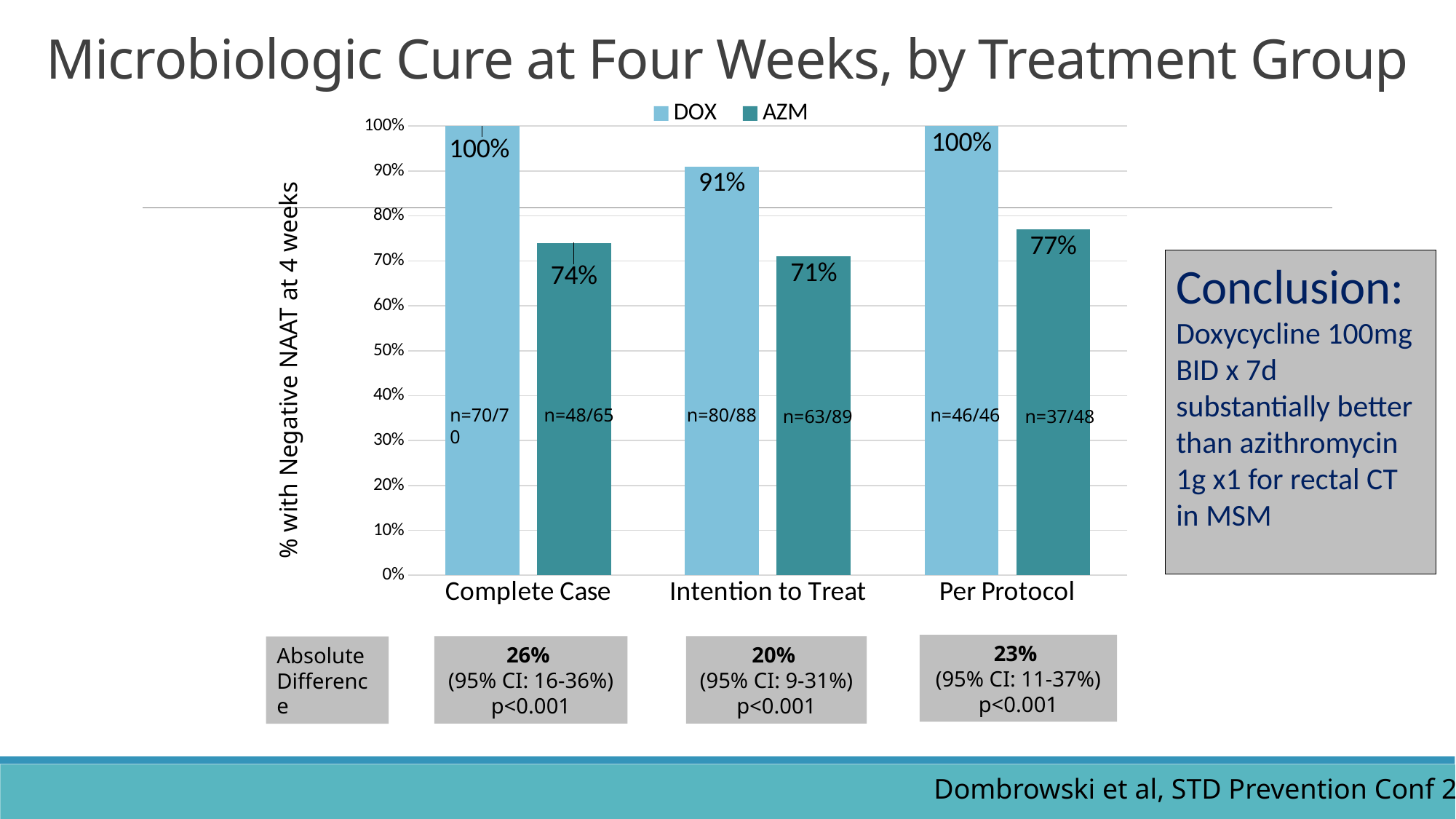
Which category has the lowest AZM value? Intention to Treat What is the DOX value for Intention to Treat? 91% Which category has the highest AZM value? Per Protocol How many series does the legend list? 2 What is the difference between the DOX and AZM values for Complete Case? 26% How many categories are shown on the x axis? 3 What is the y-axis label of the chart? % with Negative NAAT at 4 weeks Which is larger for Per Protocol, the DOX value or the AZM value? DOX What is the difference between the DOX and AZM values for Intention to Treat? 20% What is the AZM value for Complete Case? 74% What is the AZM value for Per Protocol? 77% What kind of chart is shown on the slide? Bar chart